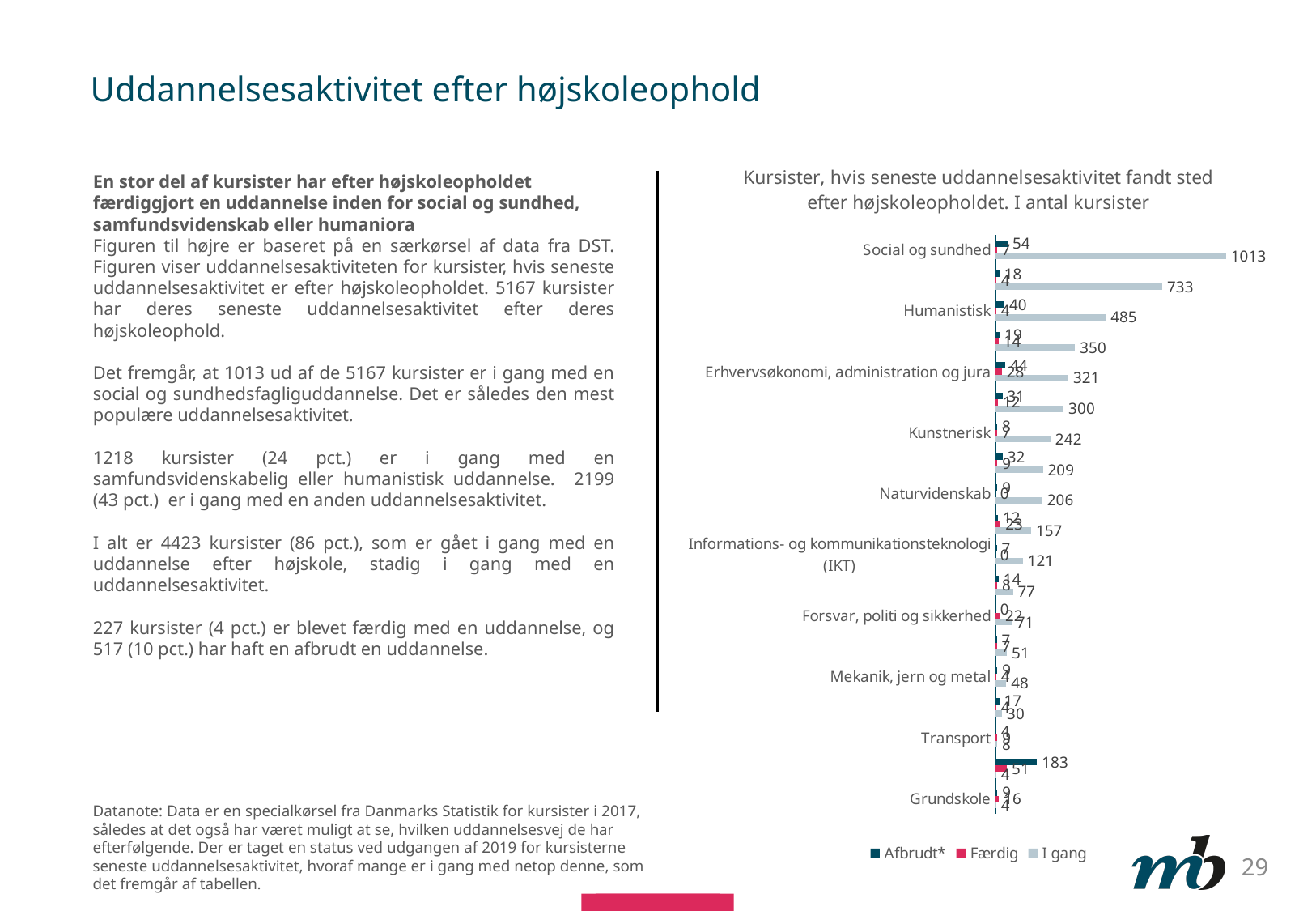
What is the 'Afbrudt*' value for Erhvervsøkonomi, administration og jura? 44 What is the difference between the 'I gang' values for Social og sundhed and Humanistisk? 528 What kind of chart is shown on the slide? bar chart What is the 'I gang' value for Social og sundhed? 1013 What is the 'I gang' value for Humanistisk? 485 What is the 'Færdig' value for Forsvar, politi og sikkerhed? 22 What is the 'I gang' value for Informations- og kommunikationsteknologi (IKT)? 121 Which category has the highest 'I gang' value? Social og sundhed Which has the larger 'I gang' value, Erhvervsøkonomi, administration og jura or Kunstnerisk? Erhvervsøkonomi, administration og jura How many series does the chart legend list? 3 What are the three series listed in the chart legend? Afbrudt*, Færdig, I gang What is the 'Afbrudt*' value for Social og sundhed? 54